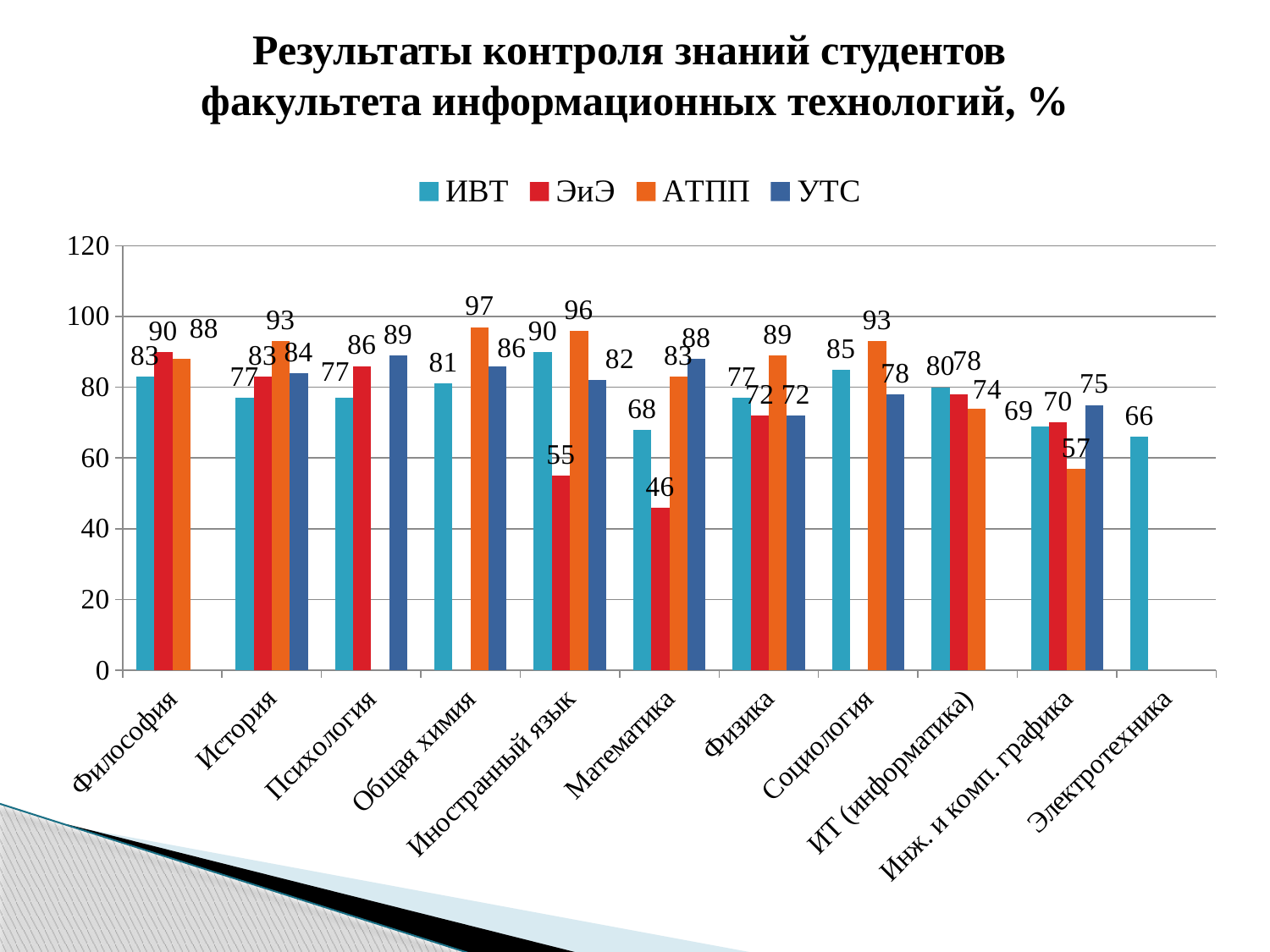
How many series does the legend list? 4 What type of chart is shown on the slide? bar chart What is the difference between the АТПП and ЭиЭ values in Иностранный язык? 41 Which is larger in Социология: the value for ИВТ or the value for УТС? ИВТ What is the value for ИВТ in Электротехника? 66 Which series is shown in orange in the legend? АТПП What is the value for АТПП in Общая химия? 97 How many subject categories are shown on the x axis? 11 Which series has the highest value in Иностранный язык? АТПП Which series has the lowest value in Инж. и комп. графика? АТПП What is the value for ЭиЭ in Математика? 46 What is the value for УТС in Психология? 89